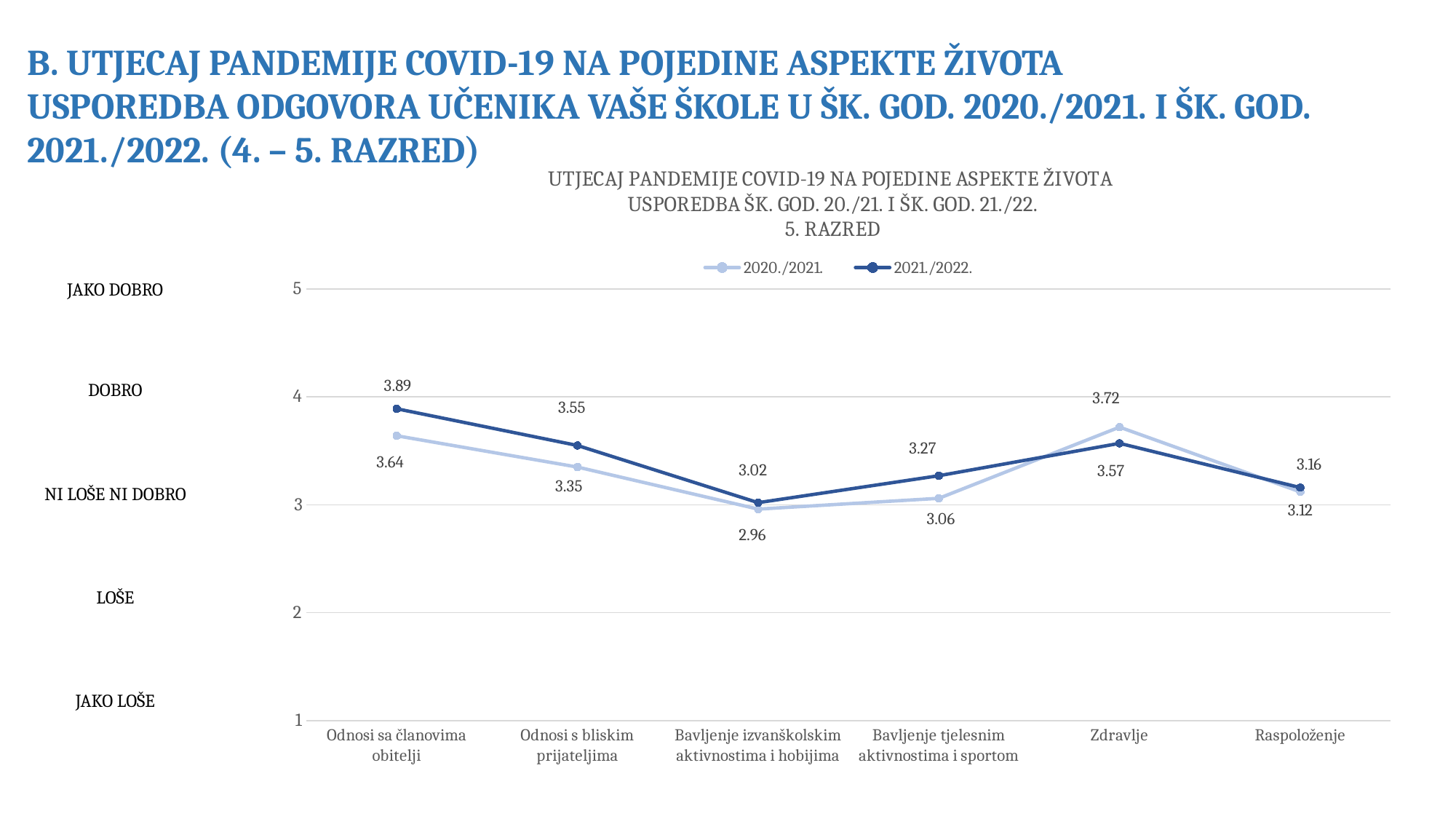
Which category has the lowest value in the 2021./2022. series? Bavljenje izvanškolskim aktivnostima i hobijima What is the value for Odnosi sa članovima obitelji in the 2021./2022. series? 3.89 How many categories are shown on the x axis? 6 What is the difference between the 2021./2022. and 2020./2021. values for Raspoloženje? 0.04 What is the value for Zdravlje in the 2020./2021. series? 3.72 What is the value for Bavljenje tjelesnim aktivnostima i sportom in the 2020./2021. series? 3.06 How many series does the legend list? 2 Which series has the larger value for Zdravlje, 2020./2021. or 2021./2022.? 2020./2021. What kind of chart is shown on the slide? line chart Is the 2020./2021. value for Bavljenje izvanškolskim aktivnostima i hobijima greater or less than 3? less What is the difference between the 2021./2022. and 2020./2021. values for Odnosi sa članovima obitelji? 0.25 Which category has the highest value in the 2020./2021. series? Zdravlje